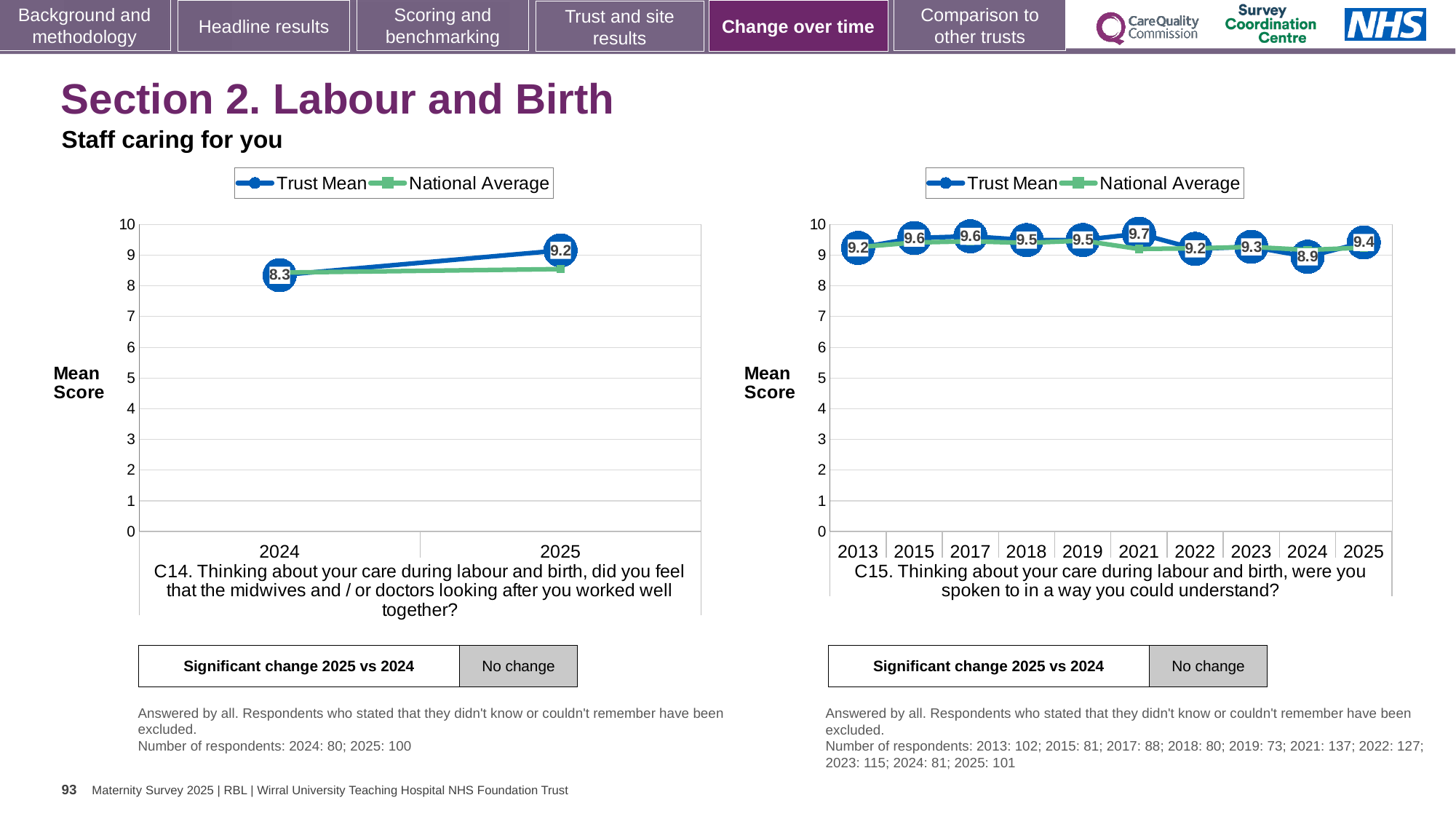
In the C15 chart on the right, is the Trust Mean for 2013 larger or smaller than the Trust Mean for 2015? smaller In the C14 chart on the left, what is the Trust Mean score for 2025? 9.2 In the C15 chart on the right, which year has the lowest Trust Mean score? 2024 In the C14 chart on the left, by how much did the Trust Mean increase from 2024 to 2025? 0.9 In the C14 chart on the left, is the National Average for 2025 greater or less than 9? less In the C14 chart on the left, does the Trust Mean rise or fall from 2024 to 2025? rise In the C14 chart on the left, what is the Trust Mean score for 2024? 8.3 In the C15 chart on the right, what is the Trust Mean score for 2021? 9.7 In the C15 chart on the right, how many years are shown on the x axis? 10 How many series does the legend of the C14 chart on the left list? 2 In the C15 chart on the right, which year has the highest Trust Mean score? 2021 In the C15 chart on the right, what is the difference between the Trust Mean in 2025 and in 2024? 0.5